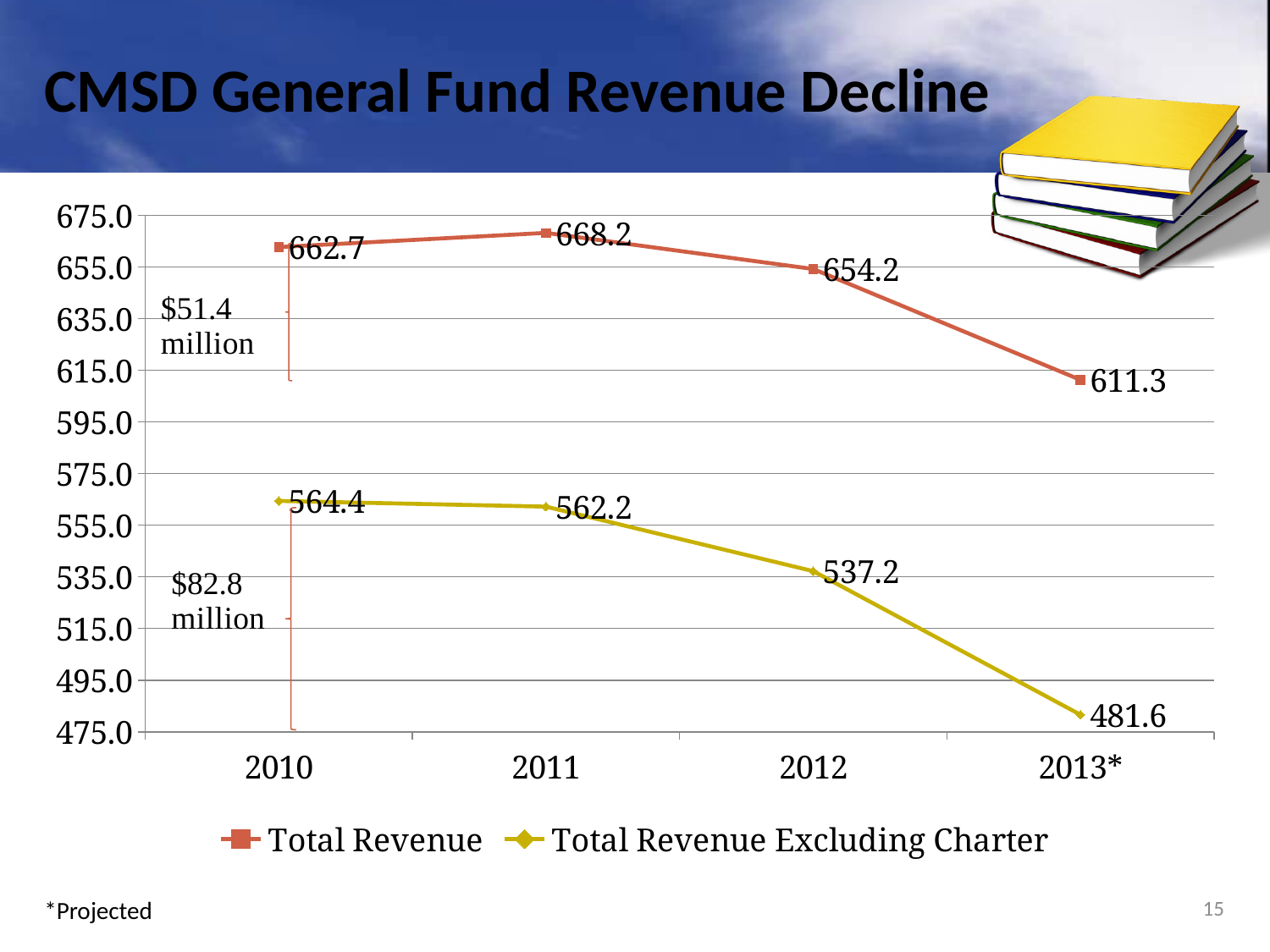
What kind of chart is shown on the slide? line chart Does Total Revenue Excluding Charter rise or fall from 2010 to 2013*? fall What is the difference between Total Revenue and Total Revenue Excluding Charter in 2010? 98.3 What is the Total Revenue value for 2012? 654.2 Which is larger: Total Revenue Excluding Charter in 2010 or in 2012? 2010 How many series does the legend list? 2 What is the Total Revenue Excluding Charter value for 2013*? 481.6 What is the difference between Total Revenue in 2011 and Total Revenue in 2013*? 56.9 What is the Total Revenue value for 2011? 668.2 In which year is Total Revenue highest? 2011 How many years are shown on the x axis? 4 In which year is Total Revenue Excluding Charter lowest? 2013*